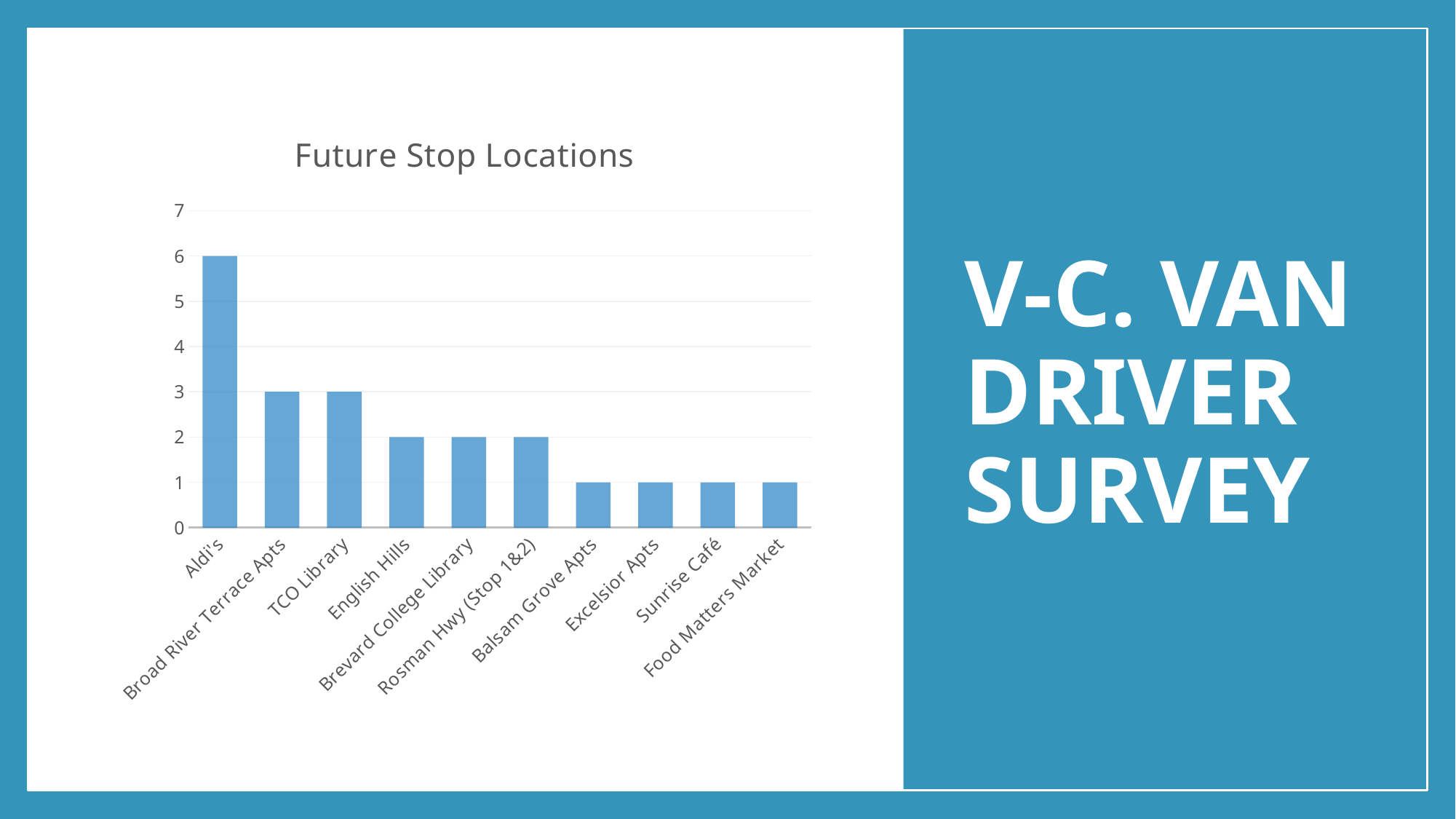
Which stop location has the highest value? Aldi's Which is larger, the value for English Hills or the value for Sunrise Café? English Hills What is the difference between the values for Aldi's and Broad River Terrace Apts? 3 How many stop locations are shown in the chart? 10 What is the value for Rosman Hwy (Stop 1&2)? 2 What is the value for Aldi's? 6 Is the value for Aldi's greater or less than 5? greater What type of chart is shown on the slide? bar chart Do the values generally rise or fall from left to right along the x axis? fall What is the value for TCO Library? 3 What is the value for Food Matters Market? 1 What is the title of the chart? Future Stop Locations